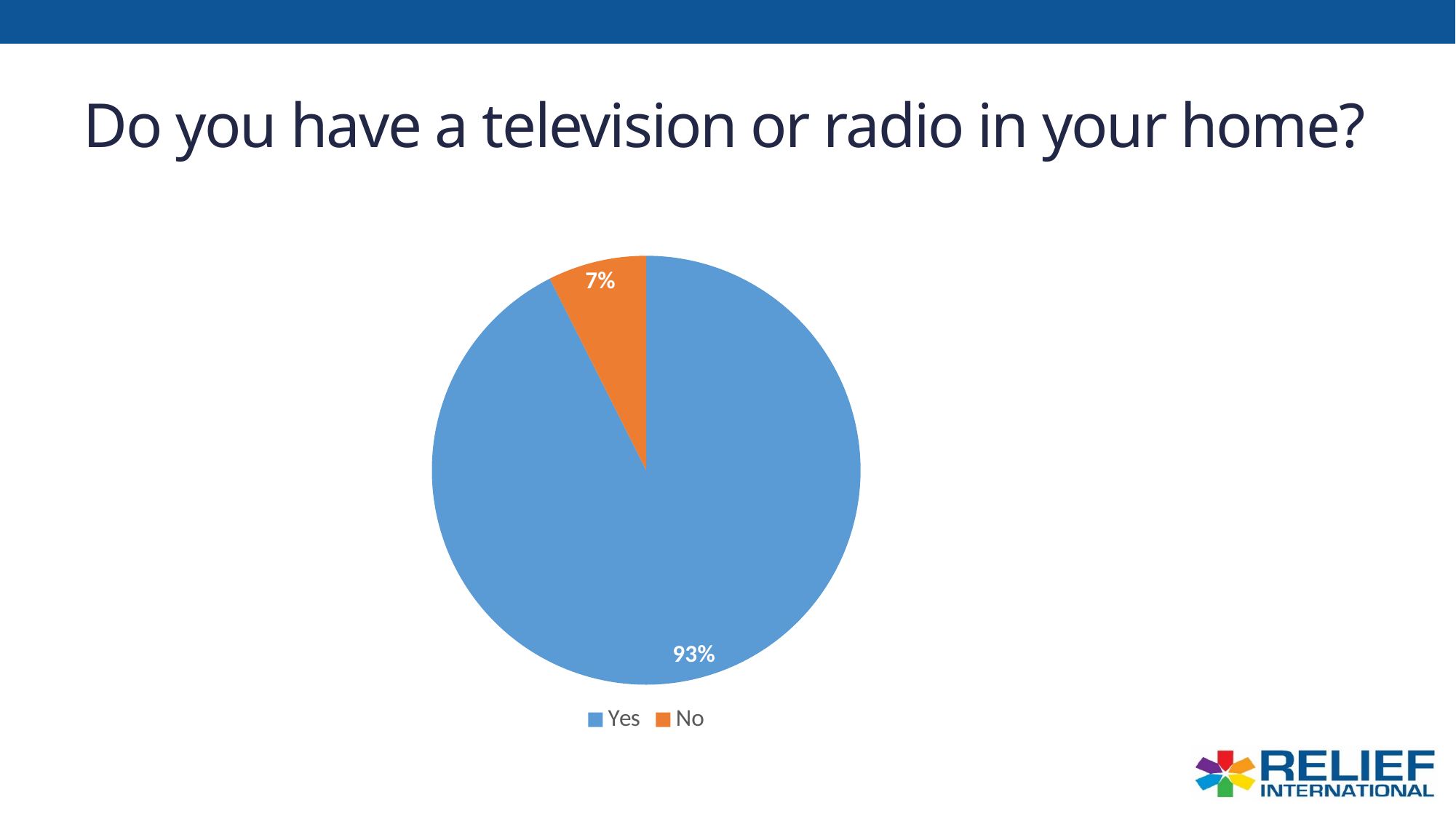
Which response has the smallest share of the pie? No What percentage of respondents answered Yes? 93% How many slices does the pie chart have? 2 What is the difference in percentage points between the Yes and No slices? 86 Which slice is larger, Yes or No? Yes Which response has the largest share of the pie? Yes What percentage of respondents answered No? 7% How many entries does the legend list? 2 What question is the chart titled with? Do you have a television or radio in your home? What kind of chart is shown on the slide? pie chart What colour is the Yes slice? blue What share of the pie does the No slice represent? 7%